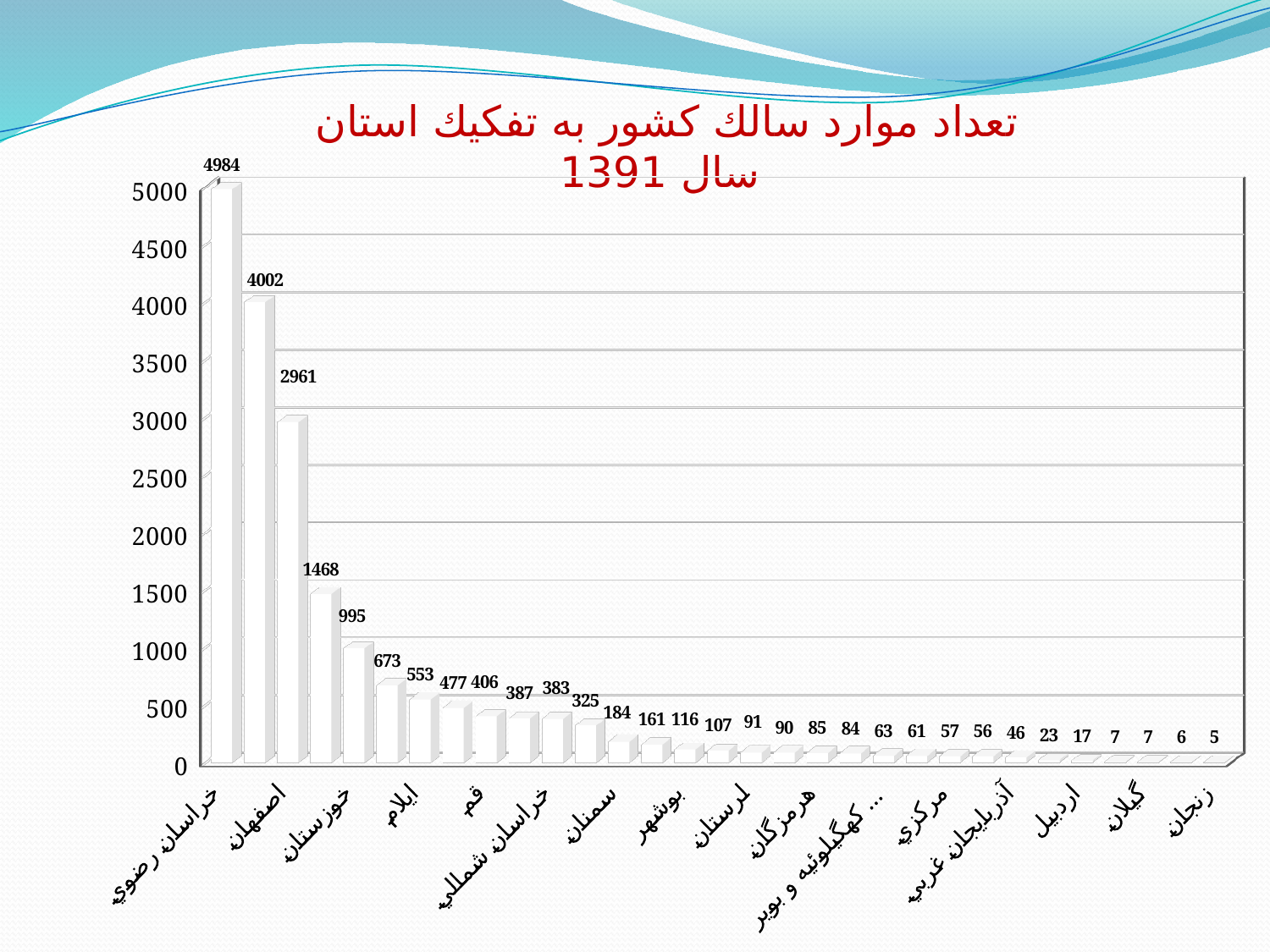
What is the value for اصفهان? 2961 What is the title of the chart? تعداد موارد سالك كشور به تفكيك استان سال 1391 Which province has the lowest number of cases? زنجان What is the value for خراسان رضوي? 4984 What kind of chart is shown on the slide? Bar chart What is the value for زنجان? 5 What is the highest value shown on the chart? 4984 Which is larger, the value for خراسان رضوي or the value for اصفهان? خراسان رضوي Is the value for اصفهان greater or less than 2500? greater Do the values rise or fall from left to right along the x axis? fall Which province has the highest number of cases? خراسان رضوي What is the difference between the highest bar (4984) and the second highest bar (4002)? 982